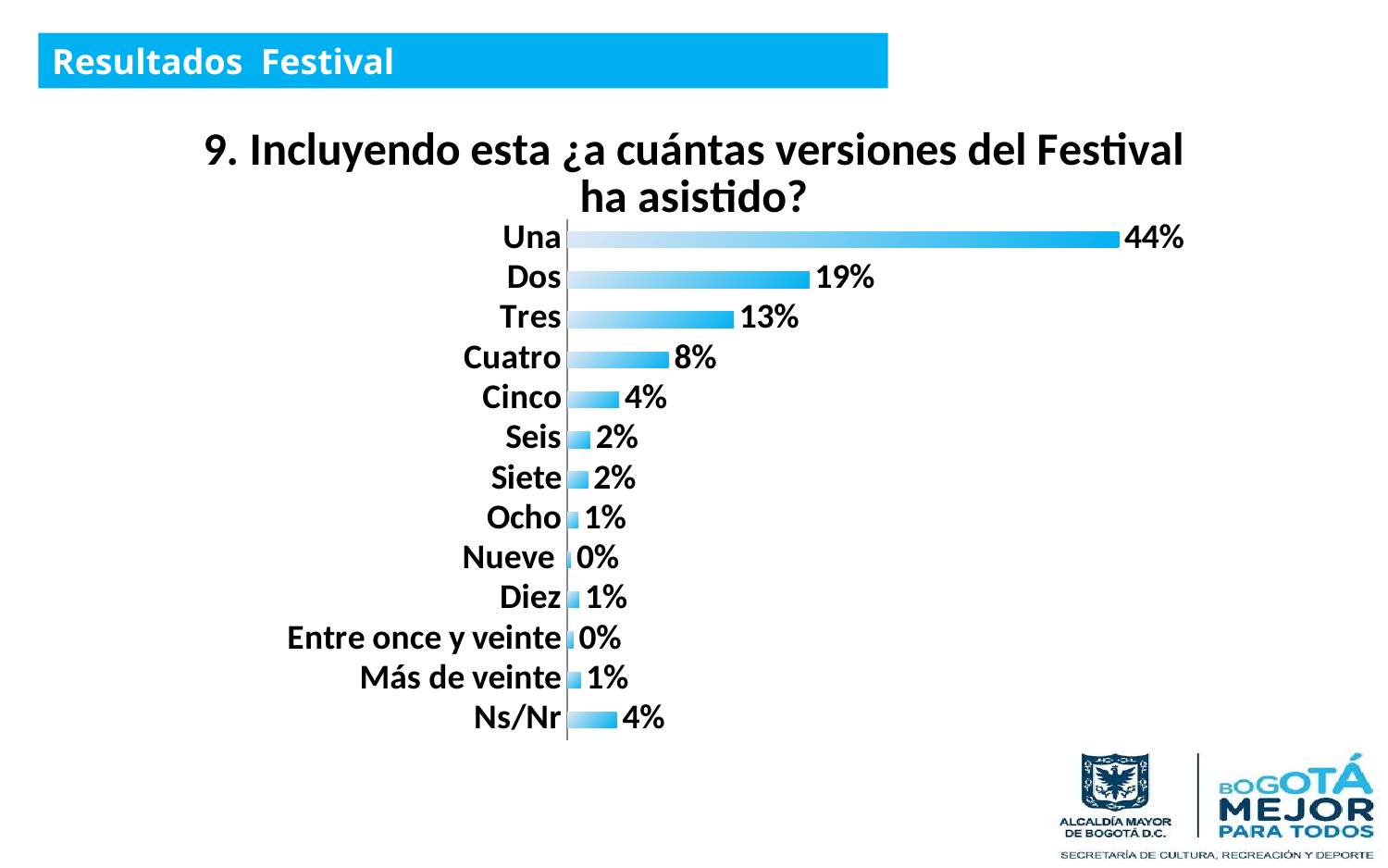
What is the value shown for 'Ns/Nr'? 4% What is the difference between the values for 'Tres' and 'Cuatro'? 5% What is the value shown for 'Nueve'? 0% What is the difference between the values for 'Una' and 'Dos'? 25% What is the value shown for 'Dos'? 19% Which is larger, the value for 'Cuatro' or the value for 'Cinco'? Cuatro What is the value shown for 'Tres'? 13% Which category has the highest value in the chart? Una What percentage of respondents said they have attended one (Una) version of the Festival? 44% What is the title of the chart? 9. Incluyendo esta ¿a cuántas versiones del Festival ha asistido? How many categories are shown in the chart? 13 What kind of chart is shown on the slide? Bar chart